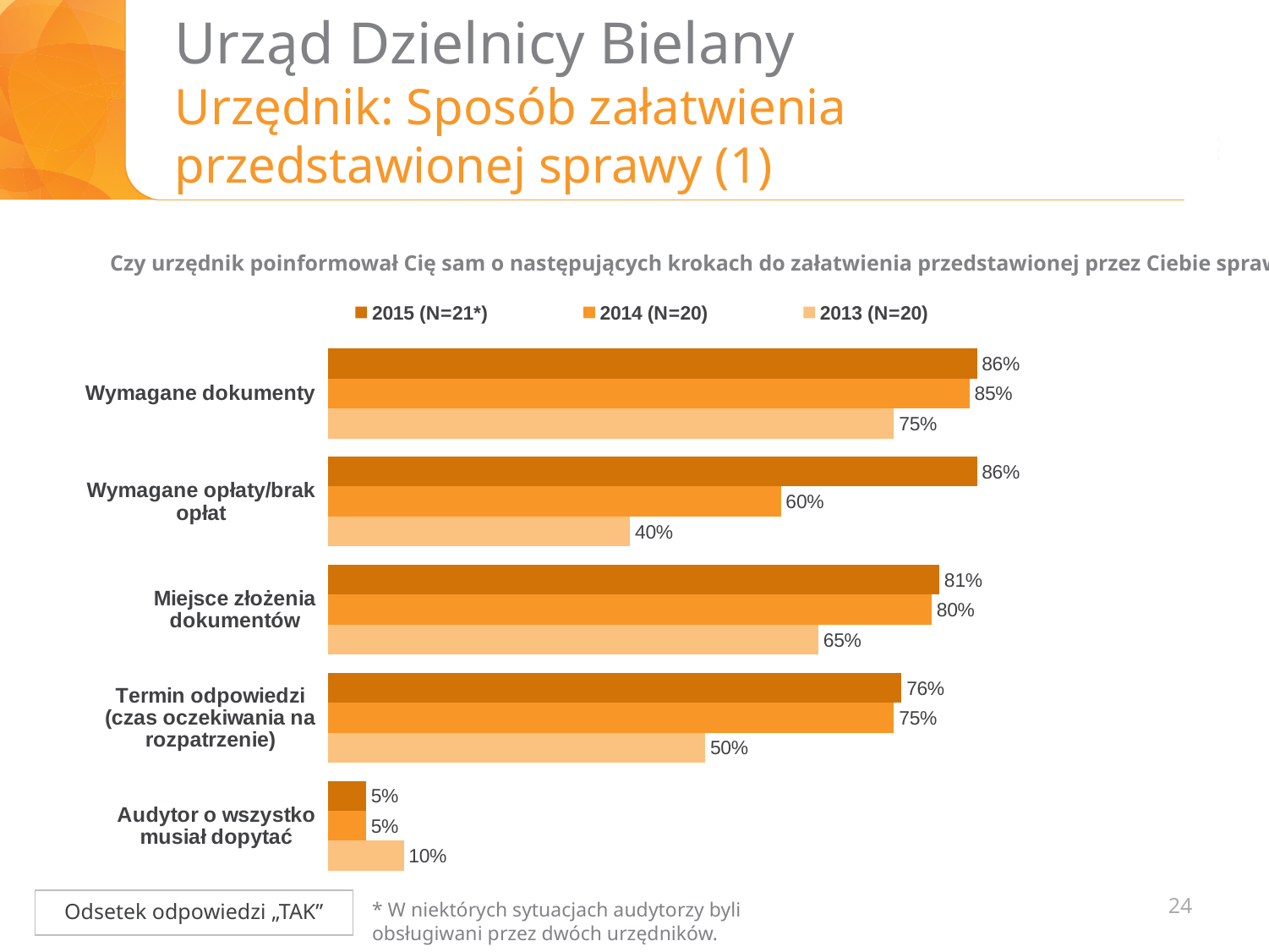
How many categories are shown on the chart? 5 What is the value for "Wymagane dokumenty" in the 2015 (N=21*) series? 86% What is the value for "Audytor o wszystko musiał dopytać" in the 2013 (N=20) series? 10% Which category has the highest value in the 2014 (N=20) series? Wymagane dokumenty Which category has the lowest value in the 2015 (N=21*) series? Audytor o wszystko musiał dopytać What is the difference between the 2015 (N=21*) and 2013 (N=20) values for "Wymagane opłaty/brak opłat"? 46 percentage points What is the value for "Wymagane opłaty/brak opłat" in the 2013 (N=20) series? 40% What is the difference between the 2014 (N=20) and 2013 (N=20) values for "Termin odpowiedzi (czas oczekiwania na rozpatrzenie)"? 25 percentage points Which is larger for "Miejsce złożenia dokumentów": the 2015 (N=21*) value or the 2013 (N=20) value? 2015 (N=21*) What kind of chart is shown on the slide? Bar chart How many series does the legend list? 3 What is the value for "Termin odpowiedzi (czas oczekiwania na rozpatrzenie)" in the 2014 (N=20) series? 75%